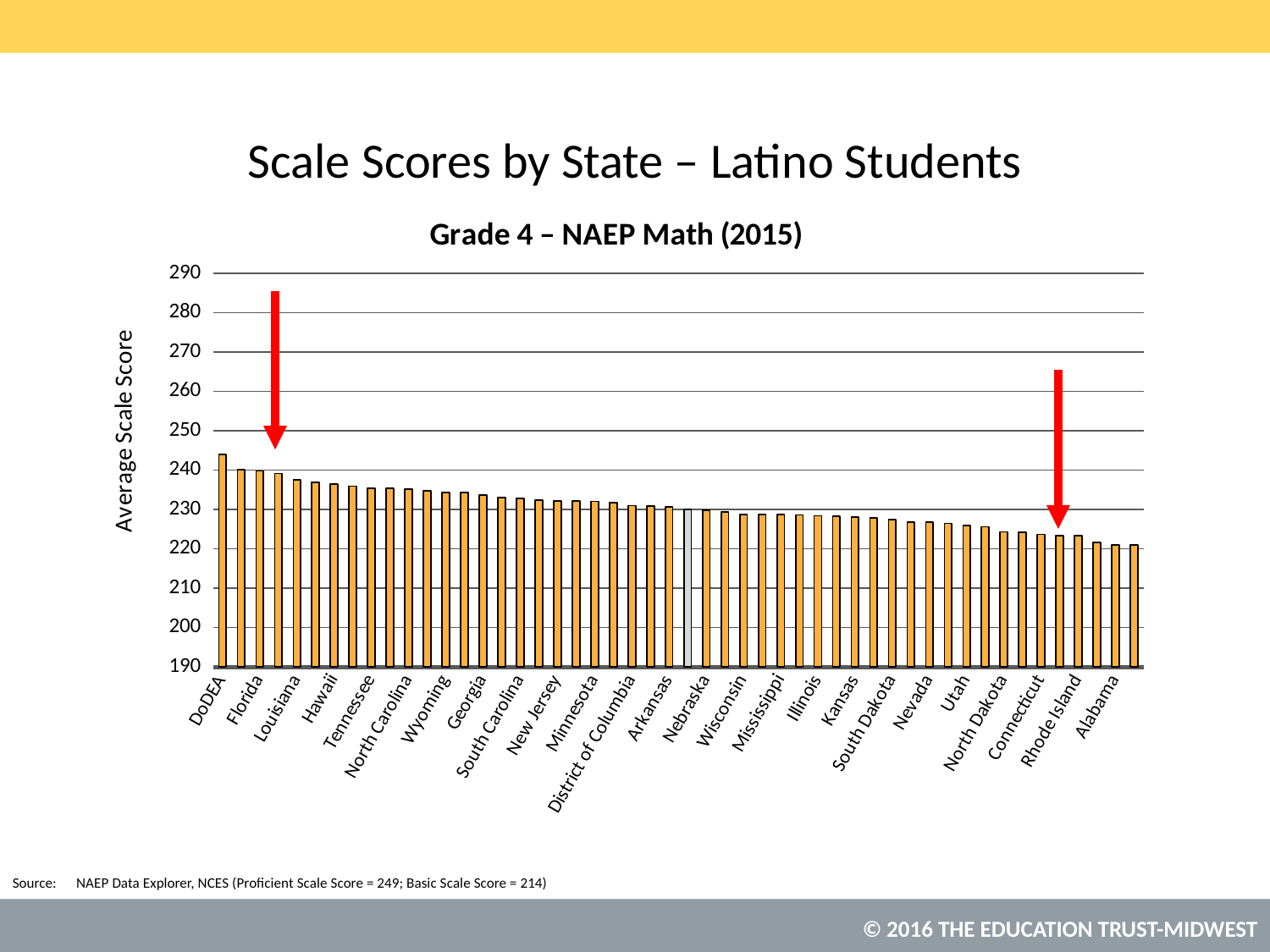
Is the value for Utah greater or less than 230? less What is the label on the vertical axis of the chart? Average Scale Score What is the title of the chart? Grade 4 – NAEP Math (2015) Which state or jurisdiction has the highest average scale score in the chart? DoDEA Is the value for Alabama greater or less than 230? less Which has a higher average scale score, DoDEA or Florida? DoDEA Is the value for DoDEA greater or less than 240? greater Which has a higher average scale score, Louisiana or Rhode Island? Louisiana What kind of chart is shown on the slide? bar chart Do the average scale scores rise or fall moving from left to right along the x axis? fall